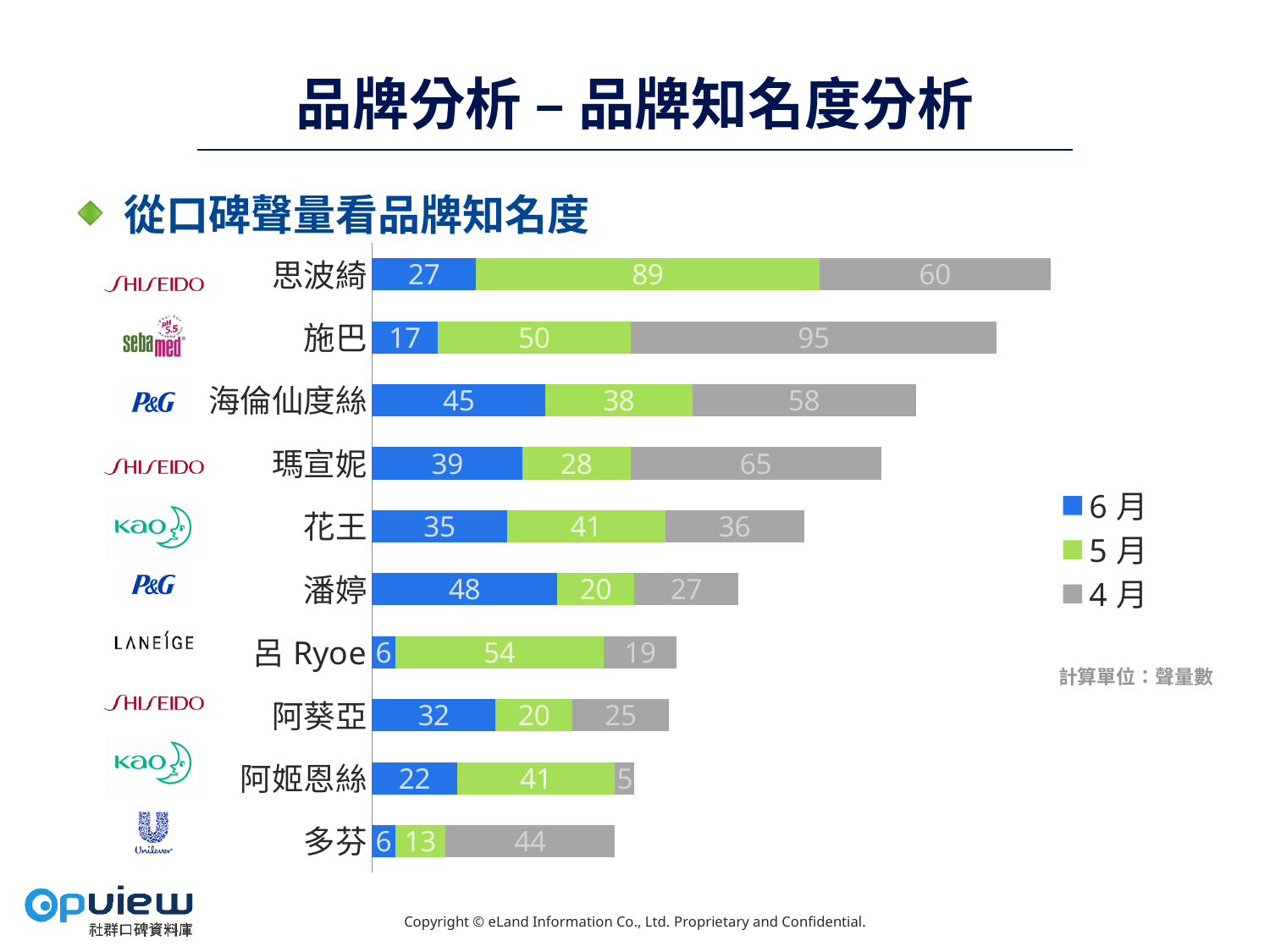
What is the 5月 value for 思波綺? 89 Which brand has the lowest 4月 value? 阿姬恩絲 What type of chart is shown on the slide? stacked bar chart What unit of measurement does the chart note say the values are in? 聲量數 Which is larger: the 5月 value for 呂 Ryoe or the 5月 value for 花王? 呂 Ryoe What is the 6月 value for 潘婷? 48 How many brands (categories) are plotted in the chart? 10 What is the 4月 value for 施巴? 95 What is the difference between the 4月 value and the 6月 value for 施巴? 78 What is the total of the stacked bar for 海倫仙度絲? 141 How many series does the legend list? 3 Which brand has the highest 6月 value? 潘婷